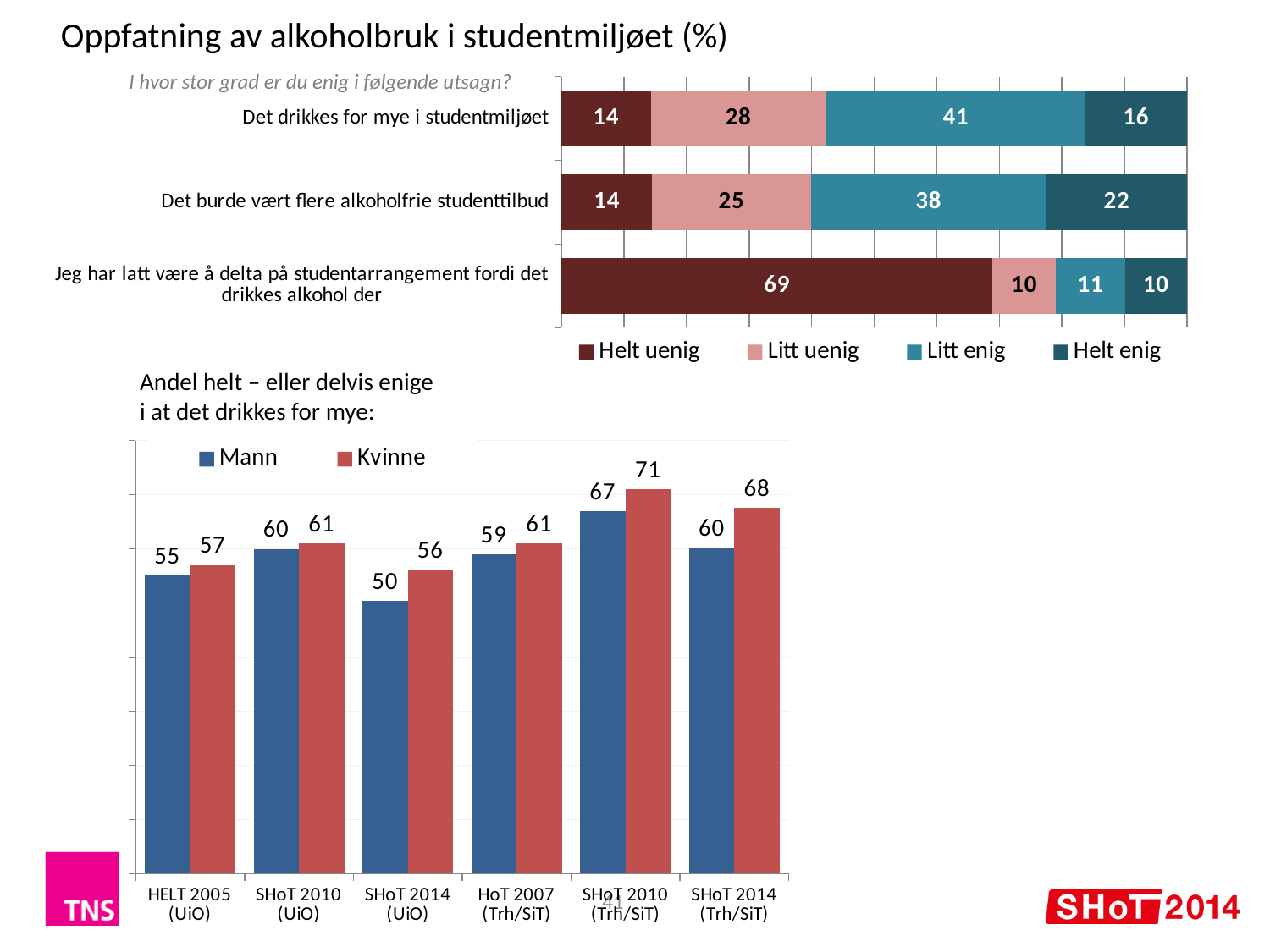
In the bottom bar chart, what is the value for Kvinne at SHoT 2010 (Trh/SiT)? 71 In the top stacked bar chart, which statement has the highest 'Helt uenig' value? Jeg har latt være å delta på studentarrangement fordi det drikkes alkohol der In the bottom bar chart, what is the value for Mann at SHoT 2014 (UiO)? 50 In the bottom bar chart, what is the difference between Kvinne and Mann at SHoT 2014 (Trh/SiT)? 8 What kind of chart is the bottom chart? Bar chart In the top stacked bar chart, what is the 'Litt enig' value for 'Det drikkes for mye i studentmiljøet'? 41 In the bottom bar chart, how many categories are shown on the x axis? 6 In the top stacked bar chart, what is the total of the bar for 'Det burde vært flere alkoholfrie studenttilbud'? 99 In the top stacked bar chart, what is the 'Helt enig' value for 'Det burde vært flere alkoholfrie studenttilbud'? 22 In the top stacked bar chart, what is the 'Helt uenig' value for 'Jeg har latt være å delta på studentarrangement fordi det drikkes alkohol der'? 69 In the top stacked bar chart, how many series does the legend list? 4 In the bottom bar chart, which category has the lowest value for Mann? SHoT 2014 (UiO)